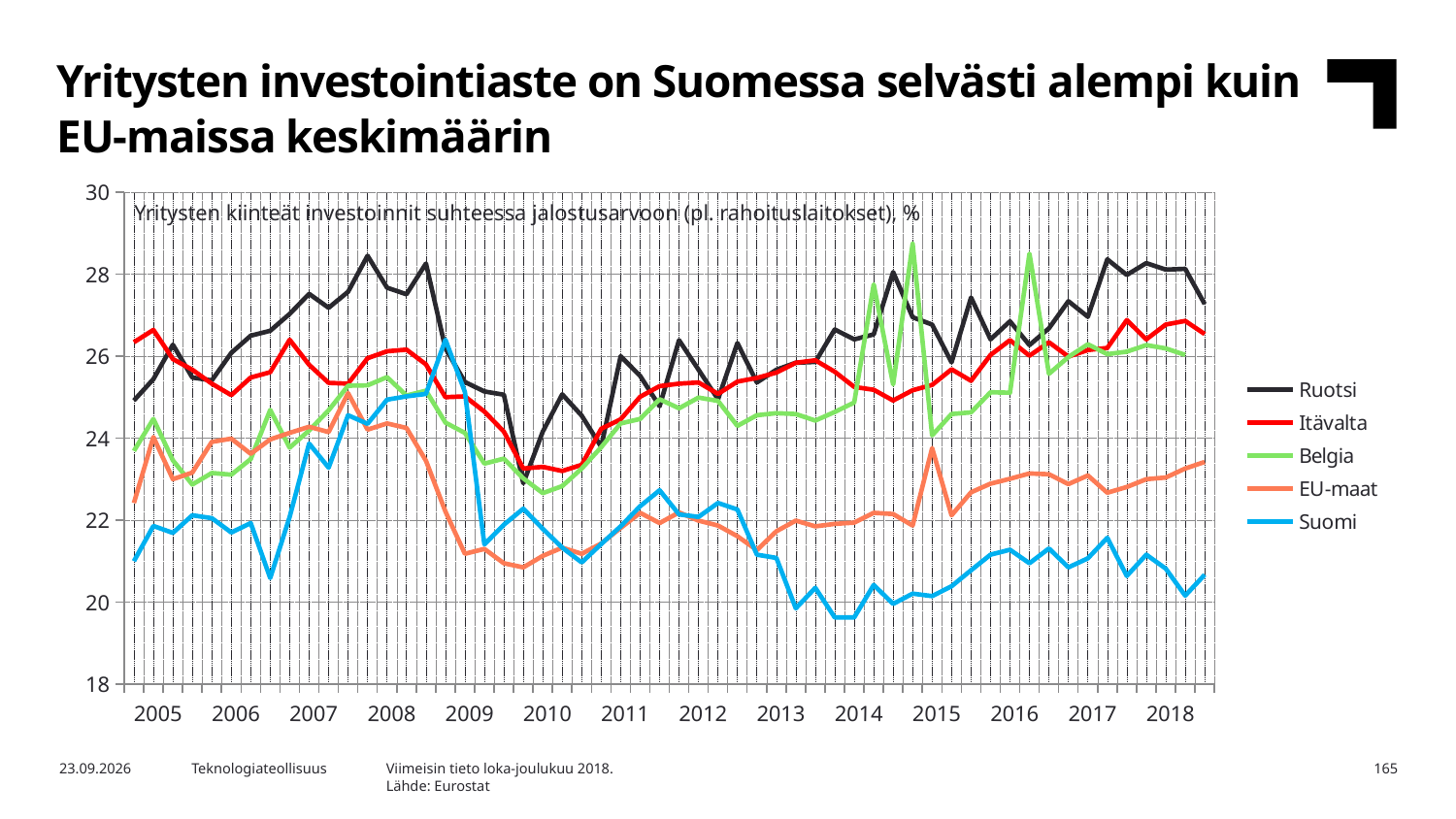
What is the subtitle printed inside the chart area? Yritysten kiinteät investoinnit suhteessa jalostusarvoon (pl. rahoituslaitokset), % How many series does the legend list? 5 What kind of chart is shown on the slide? line chart Which series has the lowest values in 2018? Suomi How many year labels are shown on the x axis? 14 Is the value for Ruotsi in 2018 greater or less than 26? greater Which series has the highest values in 2018? Ruotsi In 2018, which is larger, the value for Suomi or the value for EU-maat? EU-maat Does the Suomi line rise or fall between 2008 and 2014? fall Which series are listed in the legend? Ruotsi, Itävalta, Belgia, EU-maat, Suomi Is the value for Suomi at the end of 2018 greater or less than 22? less